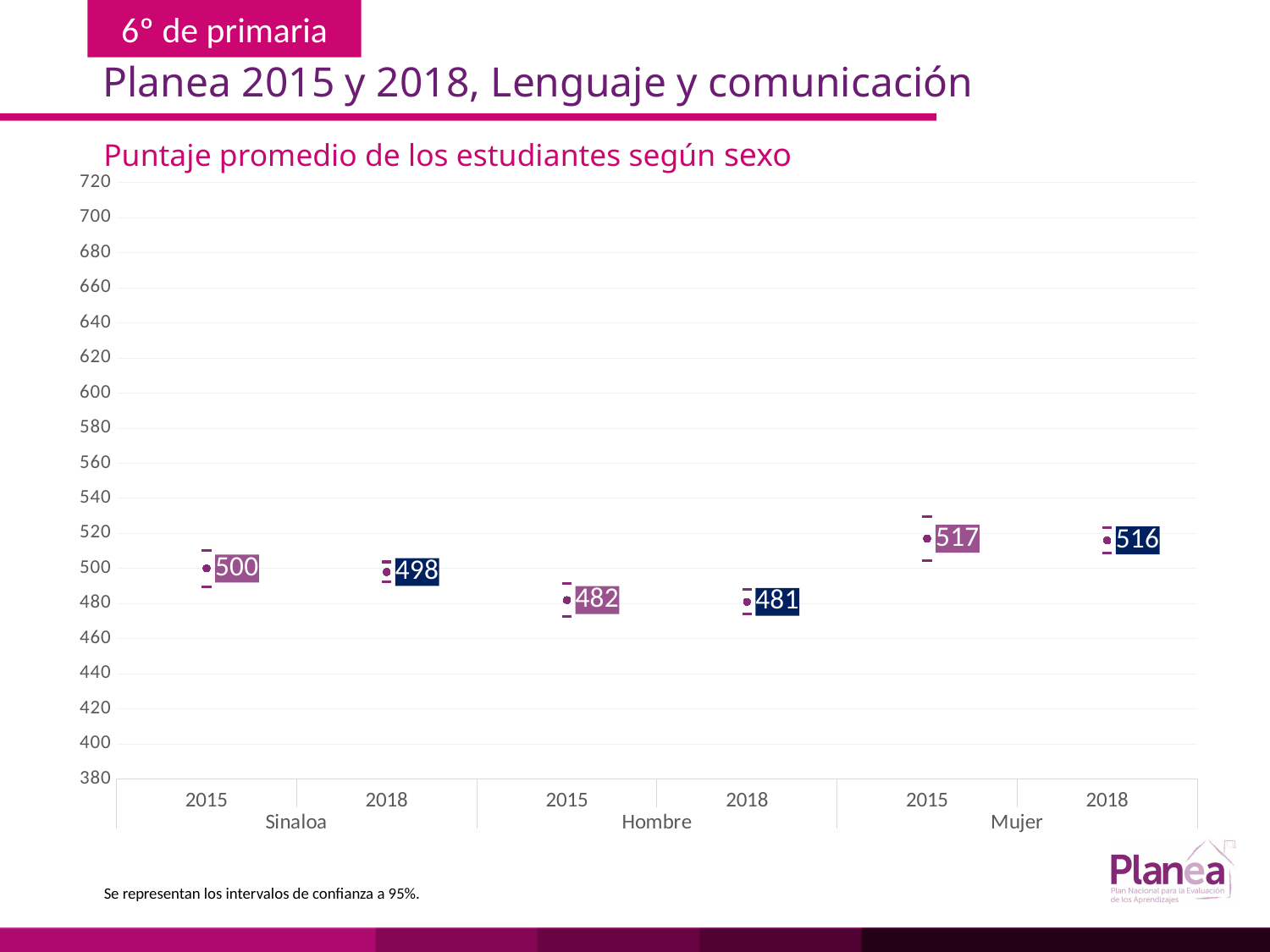
Did the average score for Hombre rise or fall from 2015 to 2018? fall Which is larger in 2018, the average score for Sinaloa or for Hombre? Sinaloa What is the difference between the Mujer and Hombre average scores in 2015? 35 What is the average score for Sinaloa in 2015? 500 What is the average score for Mujer in 2015? 517 By how much did the Sinaloa average score change from 2015 to 2018? 2 How many data points are plotted on the chart? 6 Which group and year has the highest average score? Mujer 2015 Which group and year has the lowest average score? Hombre 2018 What is the title of the chart? Puntaje promedio de los estudiantes según sexo What is the average score for Hombre in 2018? 481 Is the value for Mujer in 2018 greater or less than 500? greater